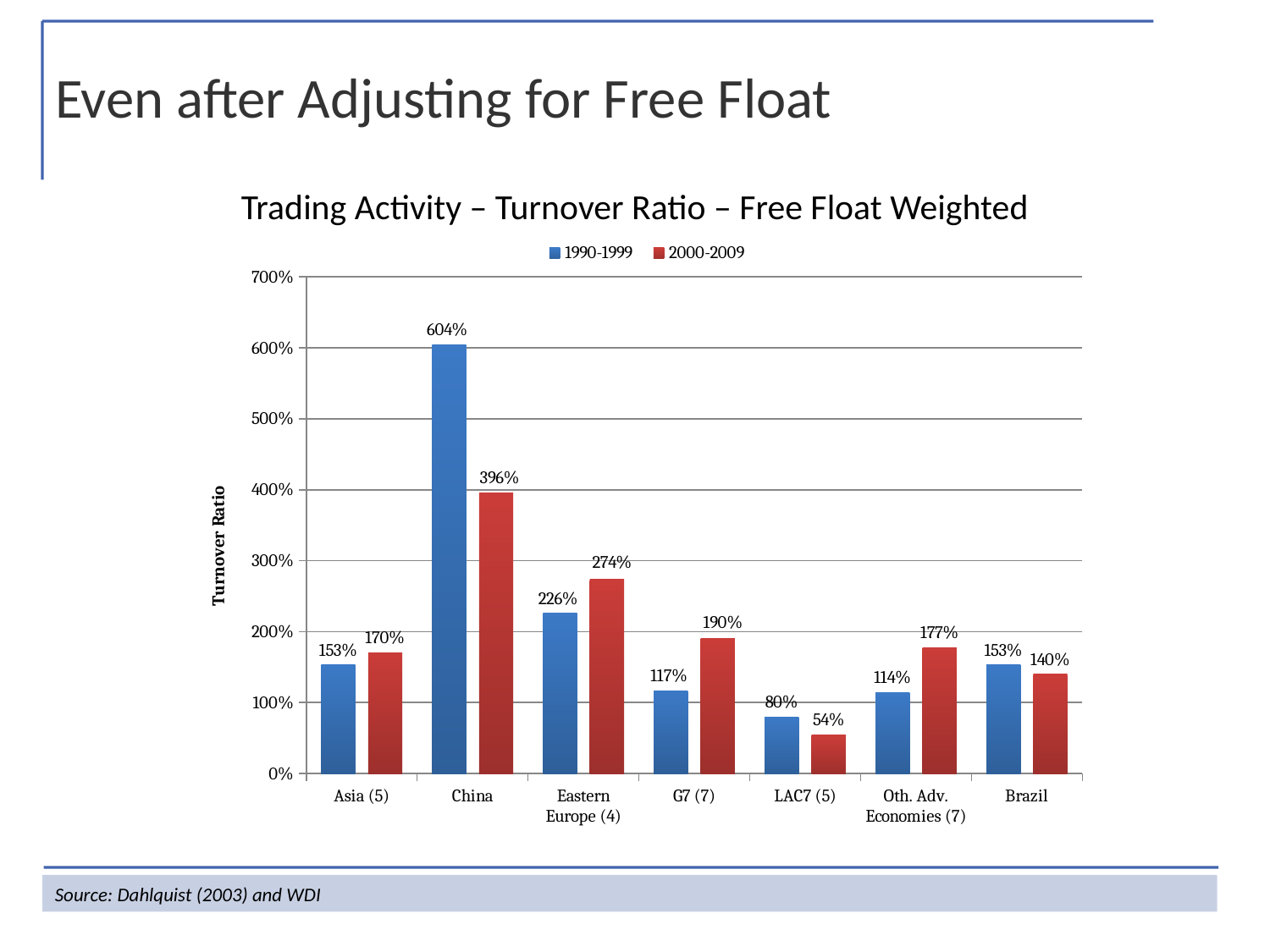
What is the turnover ratio for LAC7 (5) in 2000-2009? 54% Which category has the highest turnover ratio in the 1990-1999 series? China What kind of chart is shown on the slide? Bar chart Which is larger for Brazil: the 1990-1999 value or the 2000-2009 value? 1990-1999 How many categories are shown on the x axis? 7 What is the title of the chart? Trading Activity – Turnover Ratio – Free Float Weighted Which category has the lowest turnover ratio in the 2000-2009 series? LAC7 (5) How many series does the legend list? 2 What is the turnover ratio for Eastern Europe (4) in 2000-2009? 274% Is the 2000-2009 value for G7 (7) greater or less than 100%? greater What is the difference between China's 1990-1999 and 2000-2009 turnover ratios? 208% What is the turnover ratio for China in 1990-1999? 604%